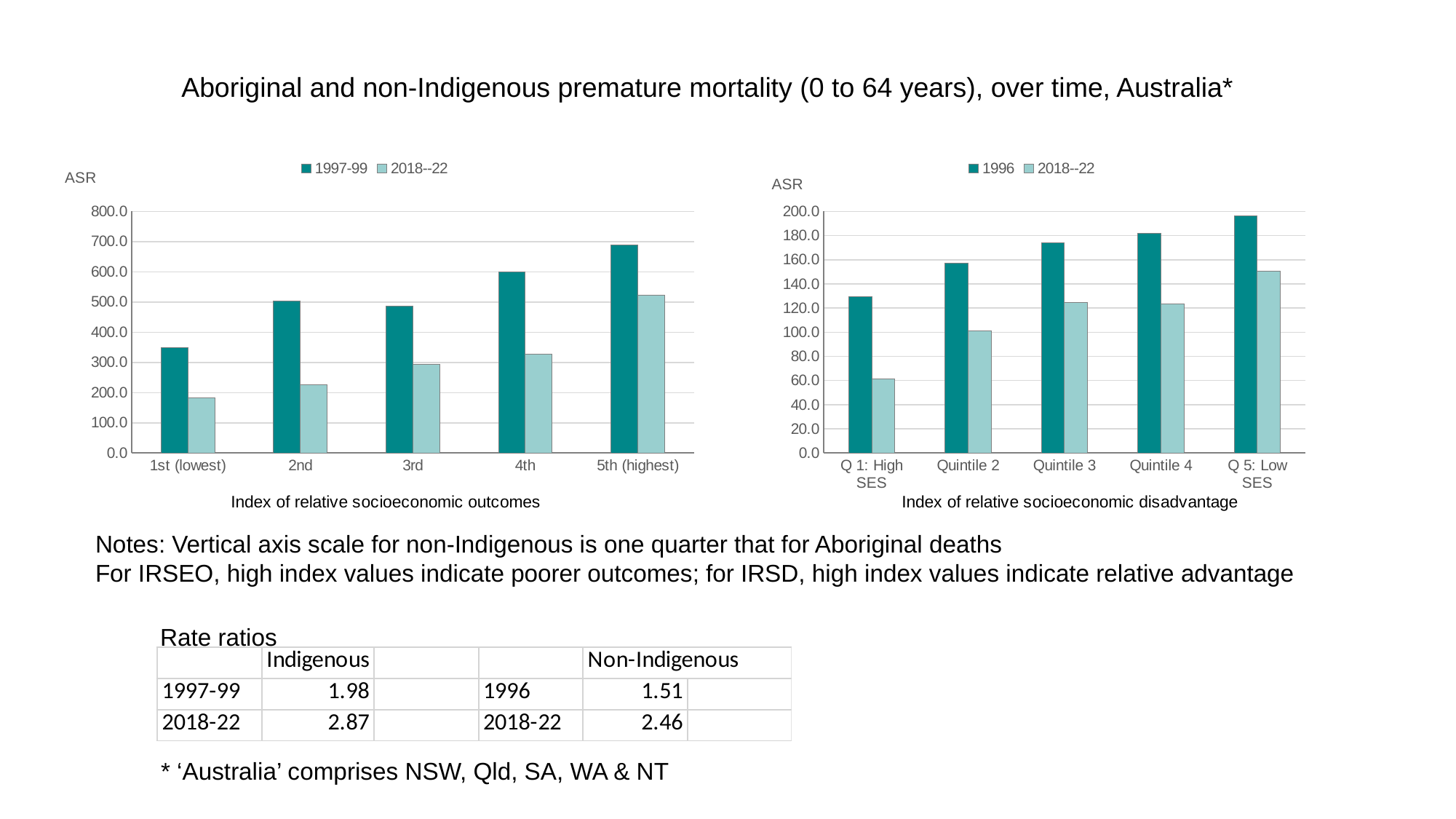
In the left chart (Index of relative socioeconomic outcomes), which category has the lowest 2018--22 value? 1st (lowest) How many series does the legend of the right chart (Index of relative socioeconomic disadvantage) list? 2 In the right chart (Index of relative socioeconomic disadvantage), is the 2018--22 value for Q 1: High SES greater or less than 80.0? less In the left chart (Index of relative socioeconomic outcomes), which category has the highest 1997-99 value? 5th (highest) What kind of chart is the left chart (Index of relative socioeconomic outcomes)? bar chart In the left chart (Index of relative socioeconomic outcomes), is the 1997-99 value for 4th greater or less than 500.0? greater How many categories are shown on the x axis of the left chart (Index of relative socioeconomic outcomes)? 5 In the right chart (Index of relative socioeconomic disadvantage), which category has the highest 2018--22 value? Q 5: Low SES In the right chart (Index of relative socioeconomic disadvantage), which is larger for Quintile 2: the 1996 value or the 2018--22 value? 1996 In the right chart (Index of relative socioeconomic disadvantage), which category has the lowest 1996 value? Q 1: High SES In the left chart (Index of relative socioeconomic outcomes), is the 2018--22 value for 2nd greater or less than 300.0? less In the right chart (Index of relative socioeconomic disadvantage), do the 1996 values rise or fall from Q 1: High SES to Q 5: Low SES? rise